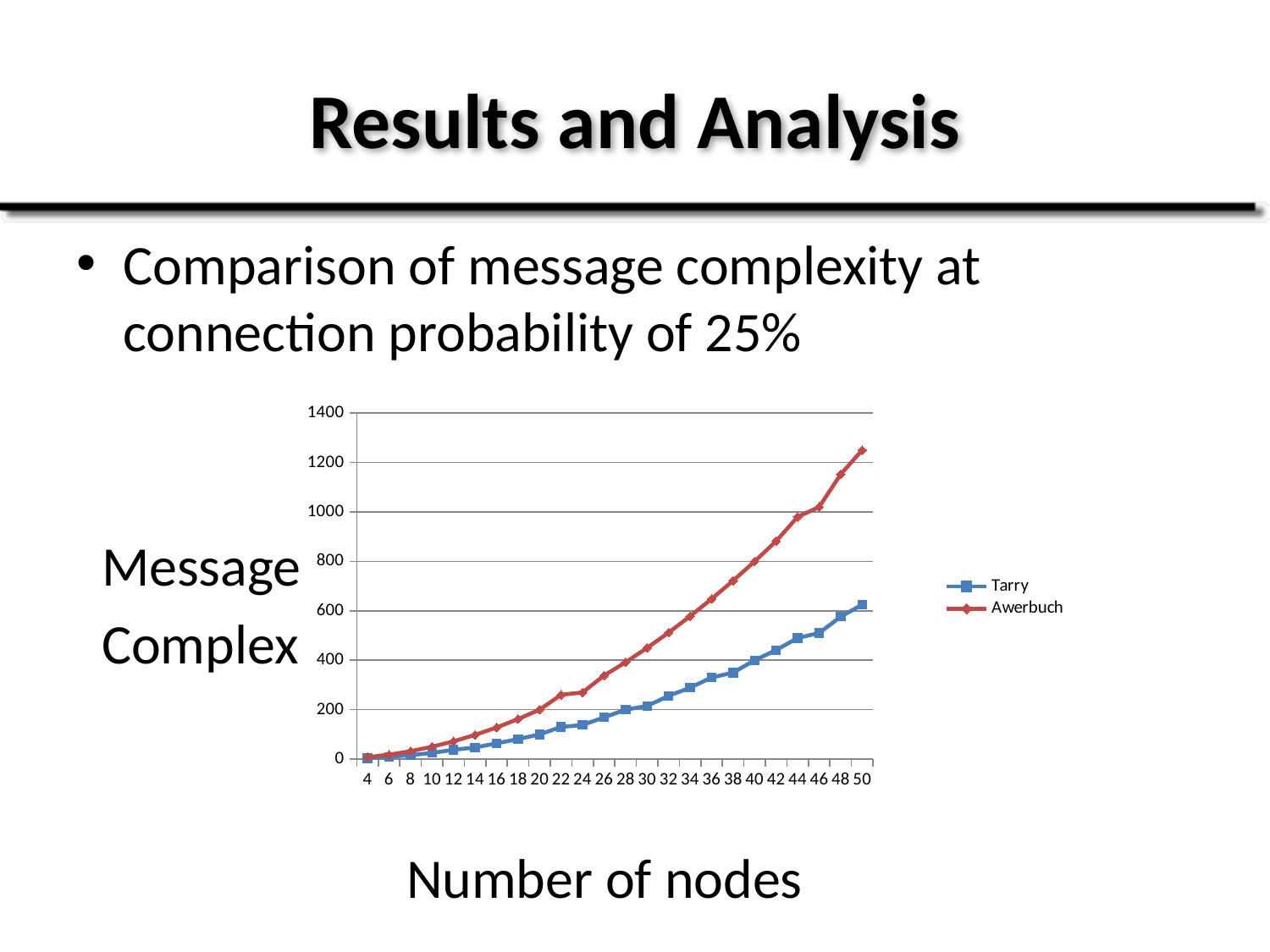
Which two series are listed in the legend? Tarry and Awerbuch What kind of chart is shown on the slide? line chart Do the values for Tarry rise or fall as the number of nodes increases? rise Is the value for Tarry at 36 nodes greater or less than 400? less How many node counts are plotted along the x axis? 24 Is the value for Tarry at 50 nodes greater or less than 400? greater Is the value for Awerbuch at 30 nodes greater or less than 400? greater At 50 nodes, which series has the larger value, Tarry or Awerbuch? Awerbuch How many series does the legend list? 2 What colour is the line for the Tarry series? blue Do the values for Awerbuch rise or fall as the number of nodes increases? rise